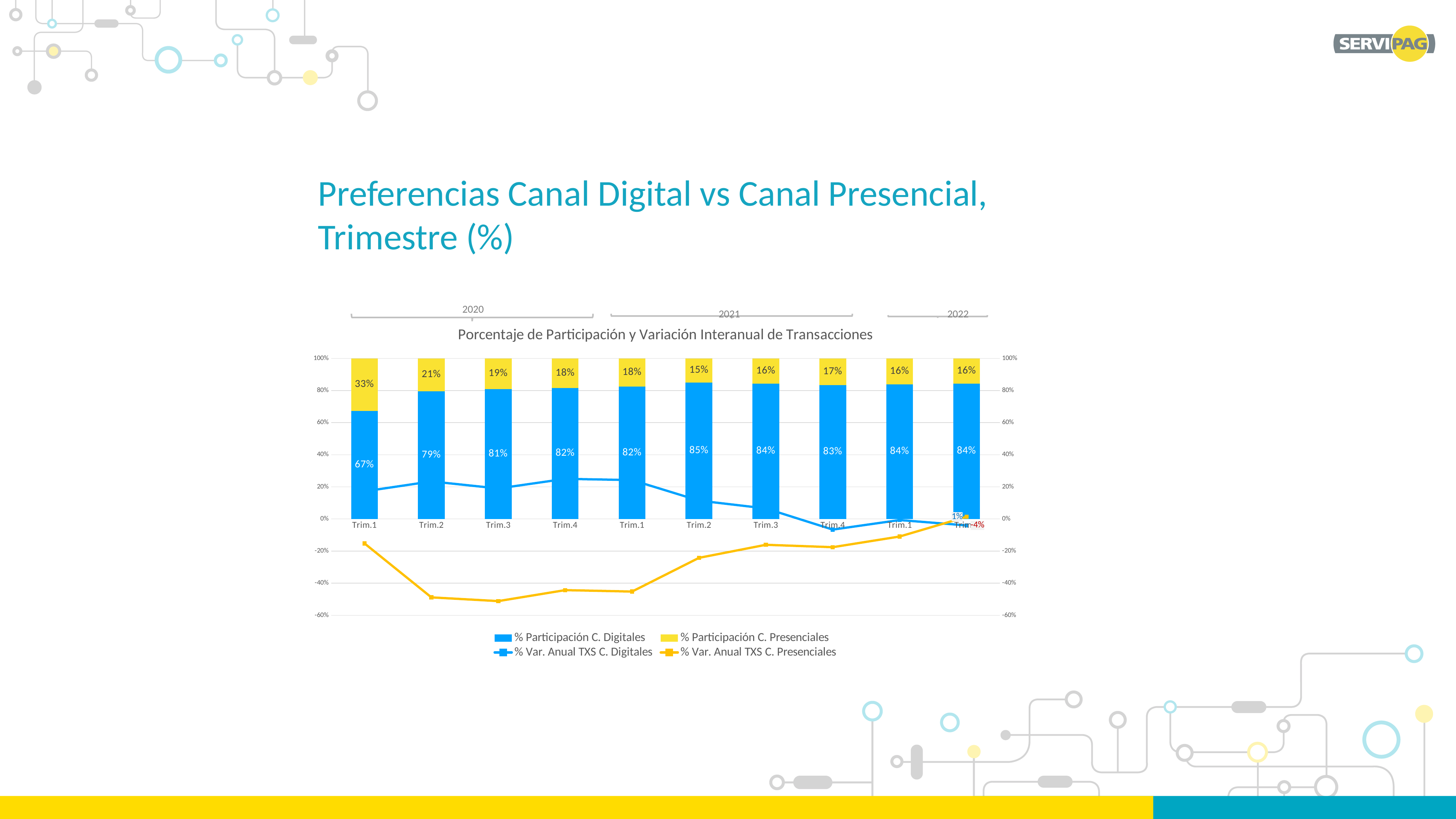
What is the % Participación C. Presenciales value for Trim.1 of 2020? 33% Which quarter has the highest % Participación C. Presenciales? Trim.1 of 2020 How many series does the legend list? 4 How many bars (quarters) are plotted in the chart? 10 What is the % Participación C. Digitales value for Trim.1 of 2020? 67% Does the % Var. Anual TXS C. Presenciales line rise or fall from Trim.3 of 2020 to Trim.1 of 2022? rise Is the % Var. Anual TXS C. Presenciales value for Trim.3 of 2020 greater or less than -40%? less What is the difference between the % Participación C. Digitales for Trim.2 of 2020 and Trim.1 of 2020? 12% What is the chart's title? Porcentaje de Participación y Variación Interanual de Transacciones What is the % Participación C. Digitales value for Trim.2 of 2021? 85% What type of chart is shown on the slide? Combined stacked bar and line chart Which quarter has the lowest % Participación C. Presenciales? Trim.2 of 2021